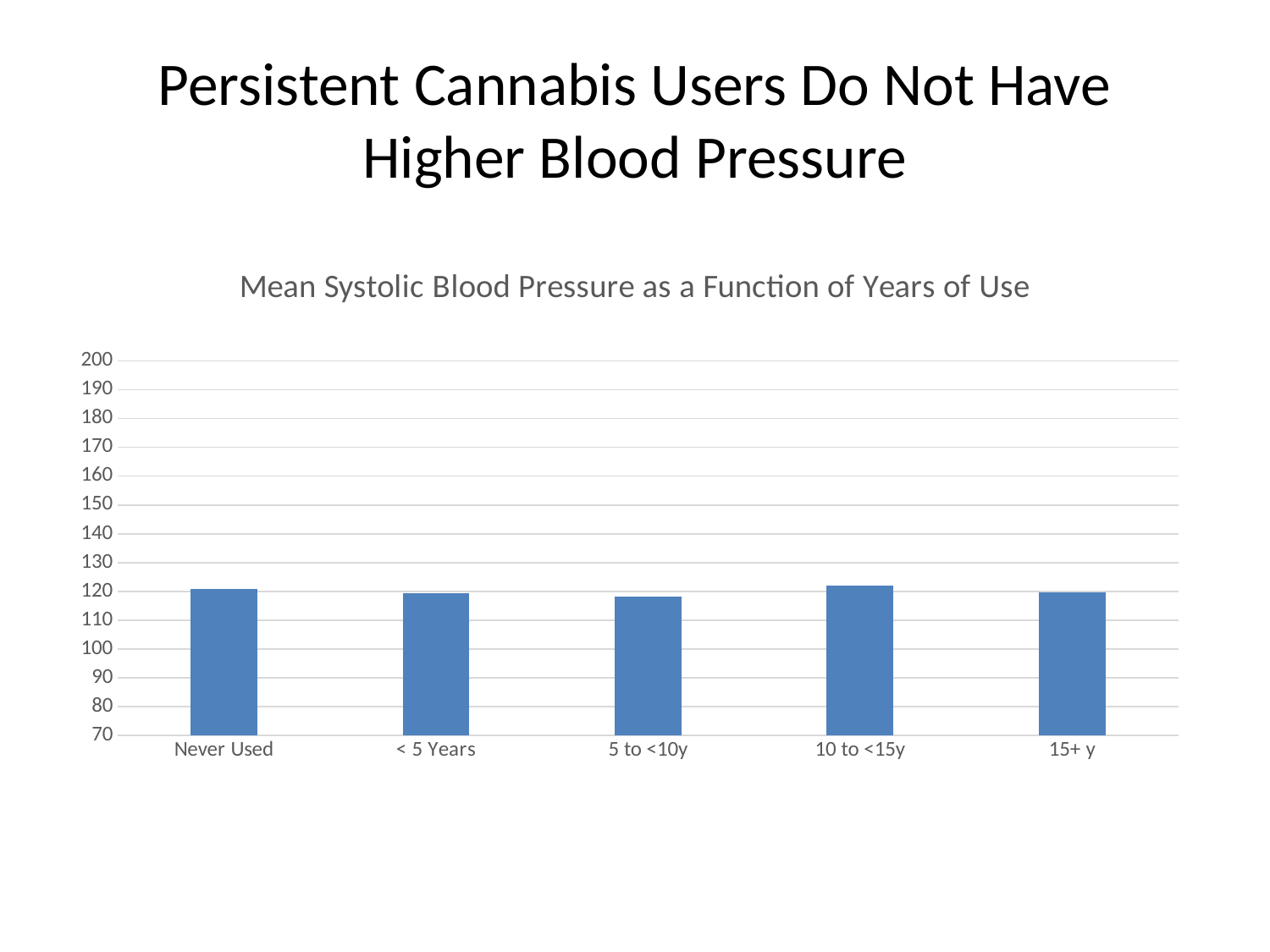
What kind of chart is shown on the slide? bar chart What is the lowest value shown on the y axis? 70 Is the value for 5 to <10y greater or less than 110? greater Is the value for 10 to <15y greater or less than 130? less How many categories of years of use are shown on the x axis? 5 Which category has the highest mean systolic blood pressure? 10 to <15y Which is larger, the value for 10 to <15y or the value for 5 to <10y? 10 to <15y Is the value for 15+ y greater or less than 110? greater What is the title of the chart? Mean Systolic Blood Pressure as a Function of Years of Use